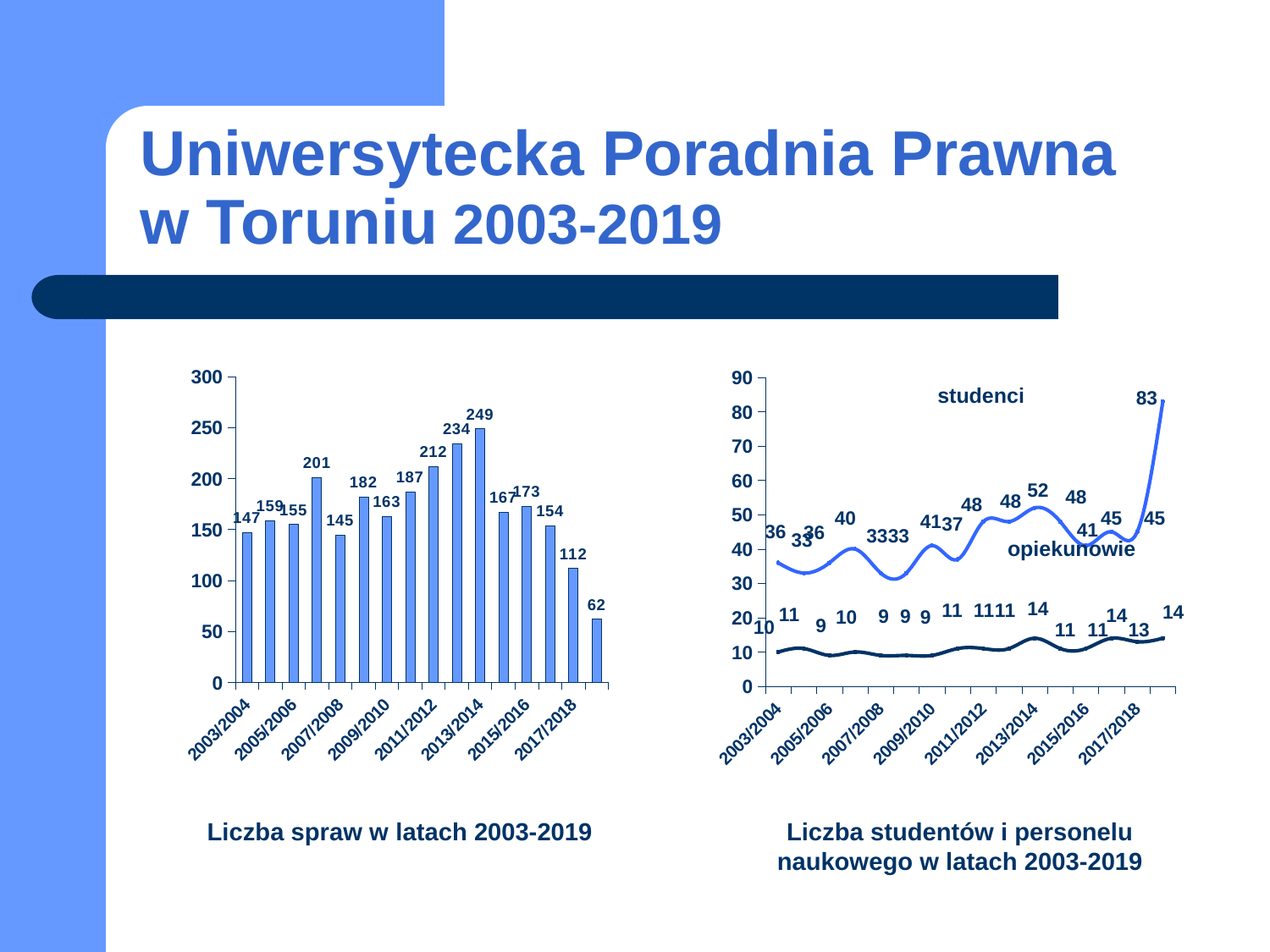
In the chart titled 'Liczba spraw w latach 2003-2019', what is the value for 2013/2014? 249 In the chart titled 'Liczba studentów i personelu naukowego w latach 2003-2019', what is the highest value for studenci? 83 In the chart titled 'Liczba studentów i personelu naukowego w latach 2003-2019', what kind of chart is shown? line chart In the chart titled 'Liczba spraw w latach 2003-2019', which year has the highest value? 2013/2014 In the chart titled 'Liczba studentów i personelu naukowego w latach 2003-2019', what is the value for studenci in 2013/2014? 52 In the chart titled 'Liczba spraw w latach 2003-2019', which is larger, the value for 2009/2010 or the value for 2015/2016? 2015/2016 In the chart titled 'Liczba spraw w latach 2003-2019', what is the difference between the values for 2011/2012 and 2017/2018? 100 In the chart titled 'Liczba spraw w latach 2003-2019', what kind of chart is shown? bar chart In the chart titled 'Liczba studentów i personelu naukowego w latach 2003-2019', how many series are plotted? 2 In the chart titled 'Liczba spraw w latach 2003-2019', what is the value for 2003/2004? 147 In the chart titled 'Liczba spraw w latach 2003-2019', what is the lowest value shown? 62 In the chart titled 'Liczba spraw w latach 2003-2019', how many bars are plotted? 16